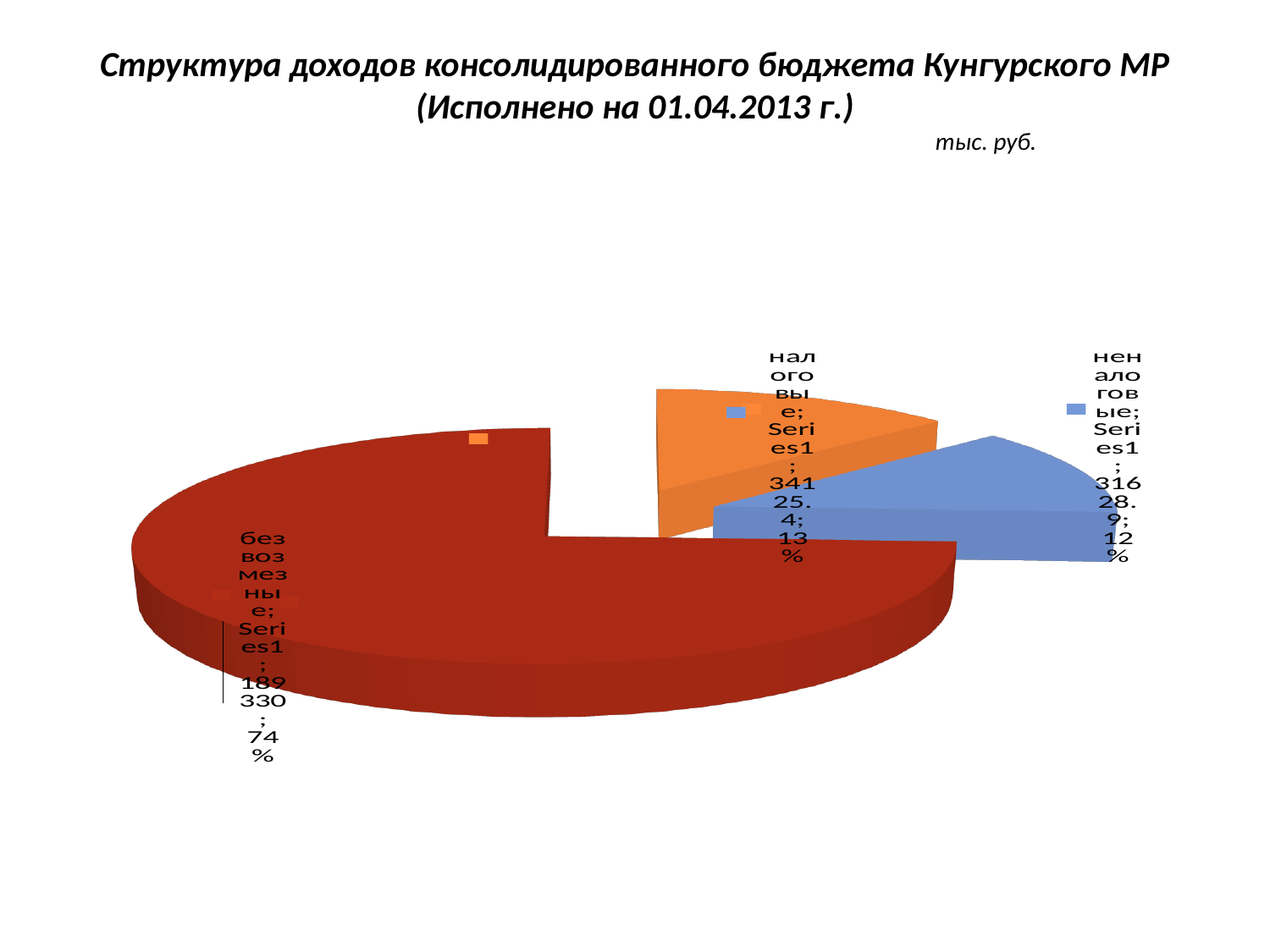
Which is larger, налоговые or неналоговые? налоговые How many slices does the pie chart have? 3 Which category has the smallest slice? неналоговые Which category has the largest slice? безвозмезные What is the value for неналоговые? 31628.9 What share of the pie does налоговые represent? 13% What share of the pie does безвозмездные represent? 74% What is the value for безвозмездные? 189330 What share of the pie does неналоговые represent? 12% What type of chart is shown on the slide? pie chart What unit is stated for the values on the slide? тыс. руб. What is the value for налоговые? 34125.4